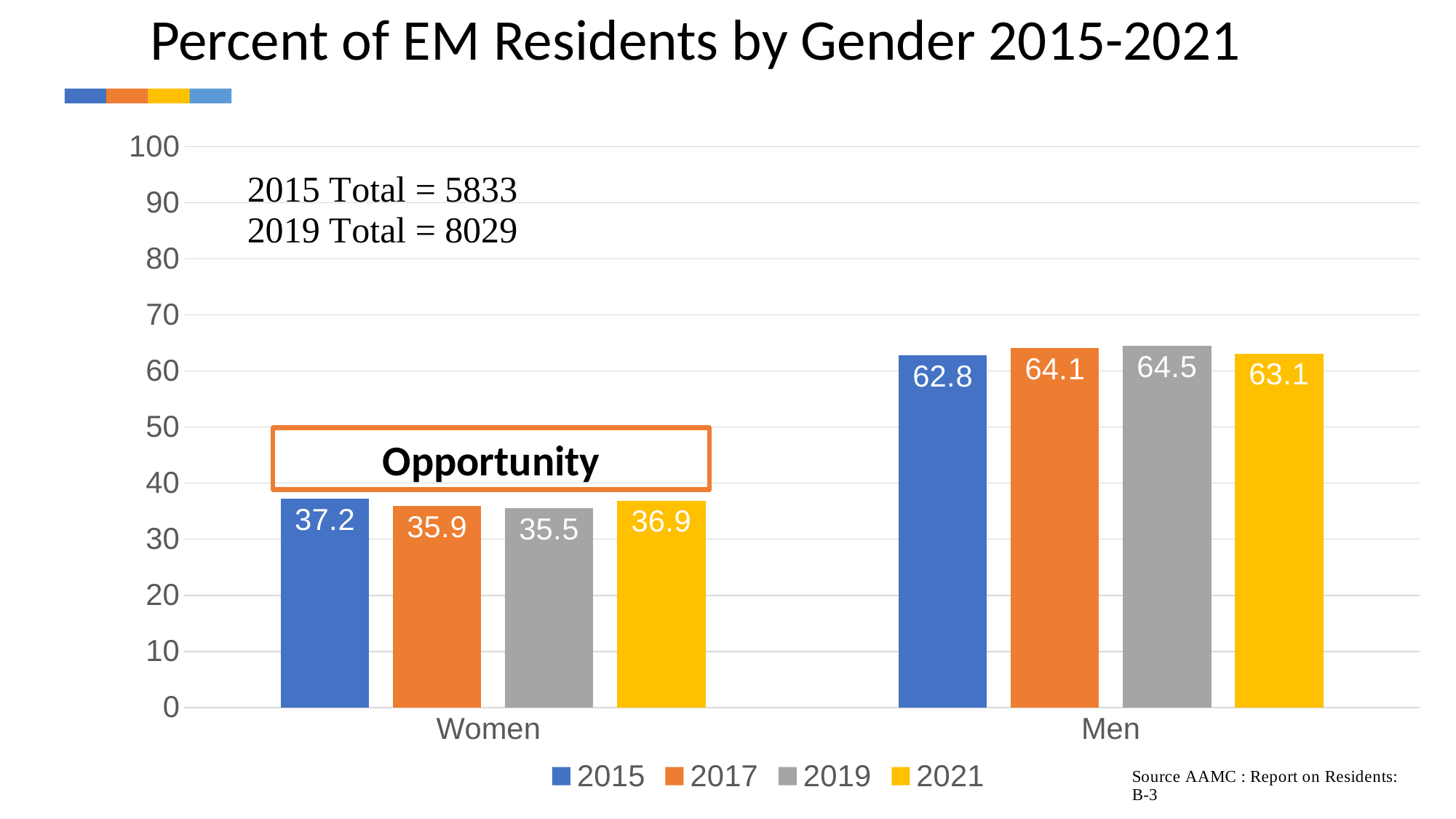
How many categories are shown on the x axis? 2 Is the value for Men in 2021 greater or less than 60? greater What is the title of the chart? Percent of EM Residents by Gender 2015-2021 What is the value for Men in 2019? 64.5 Which is larger, the Women value in 2015 or the Women value in 2021? Women value in 2015 What kind of chart is shown on the slide? bar chart How many series does the legend list? 4 Which year has the lowest value for Women? 2019 What is the value for Women in 2015? 37.2 What is the difference between the Men and Women values in 2017? 28.2 What is the value for Women in 2021? 36.9 Which year has the highest value for Men? 2019